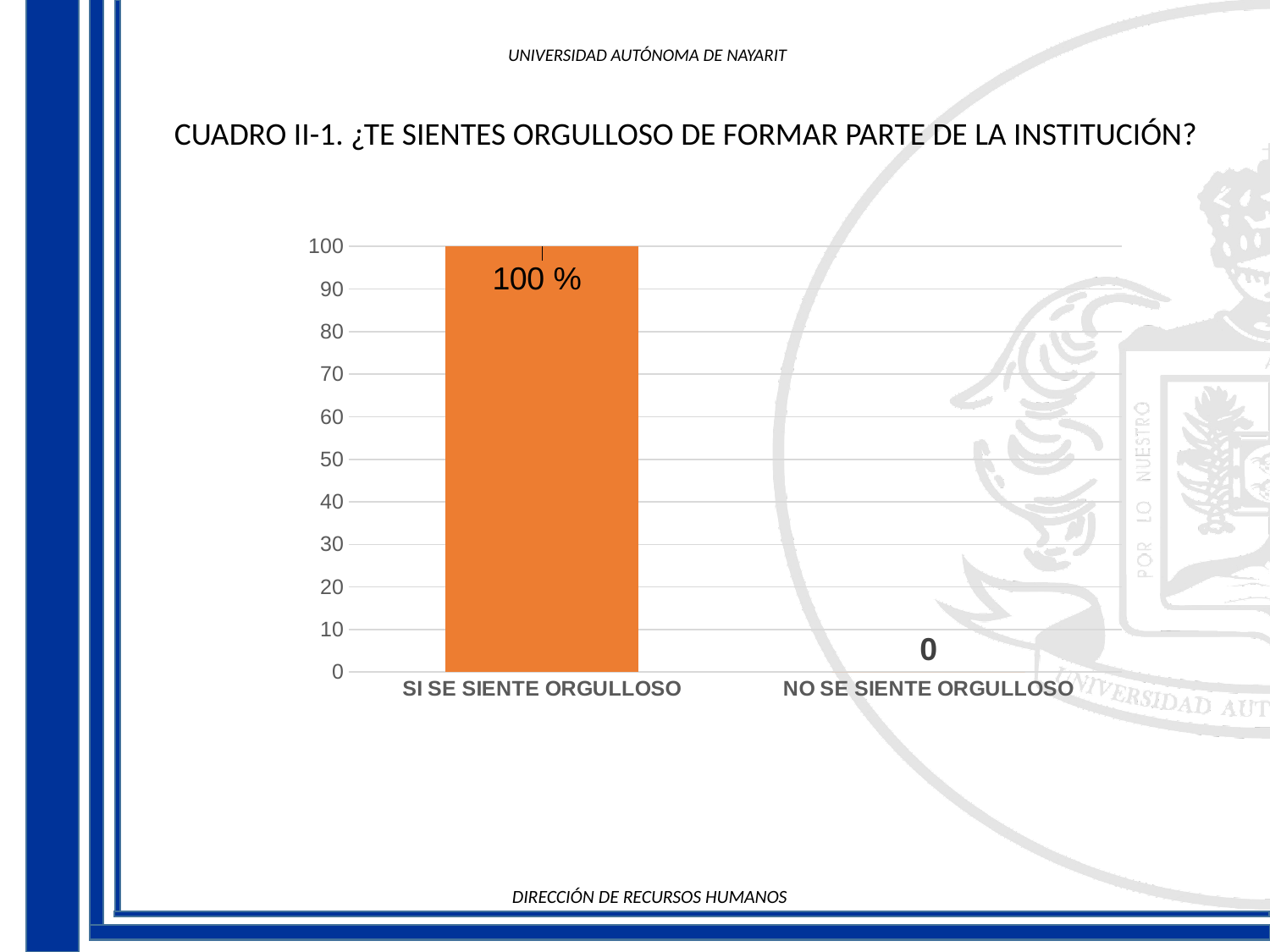
What is the value for SI SE SIENTE ORGULLOSO? 100 % Which is larger, the value for SI SE SIENTE ORGULLOSO or NO SE SIENTE ORGULLOSO? SI SE SIENTE ORGULLOSO Which category has the lowest value? NO SE SIENTE ORGULLOSO How many categories are shown on the x axis? 2 Is the value for SI SE SIENTE ORGULLOSO greater or less than 50? greater What kind of chart is shown on the slide? bar chart What colour is the bar for SI SE SIENTE ORGULLOSO? orange What is the value for NO SE SIENTE ORGULLOSO? 0 What is the maximum value shown on the y axis? 100 What is the title of the chart? CUADRO II-1. ¿TE SIENTES ORGULLOSO DE FORMAR PARTE DE LA INSTITUCIÓN? Which category has the highest value? SI SE SIENTE ORGULLOSO